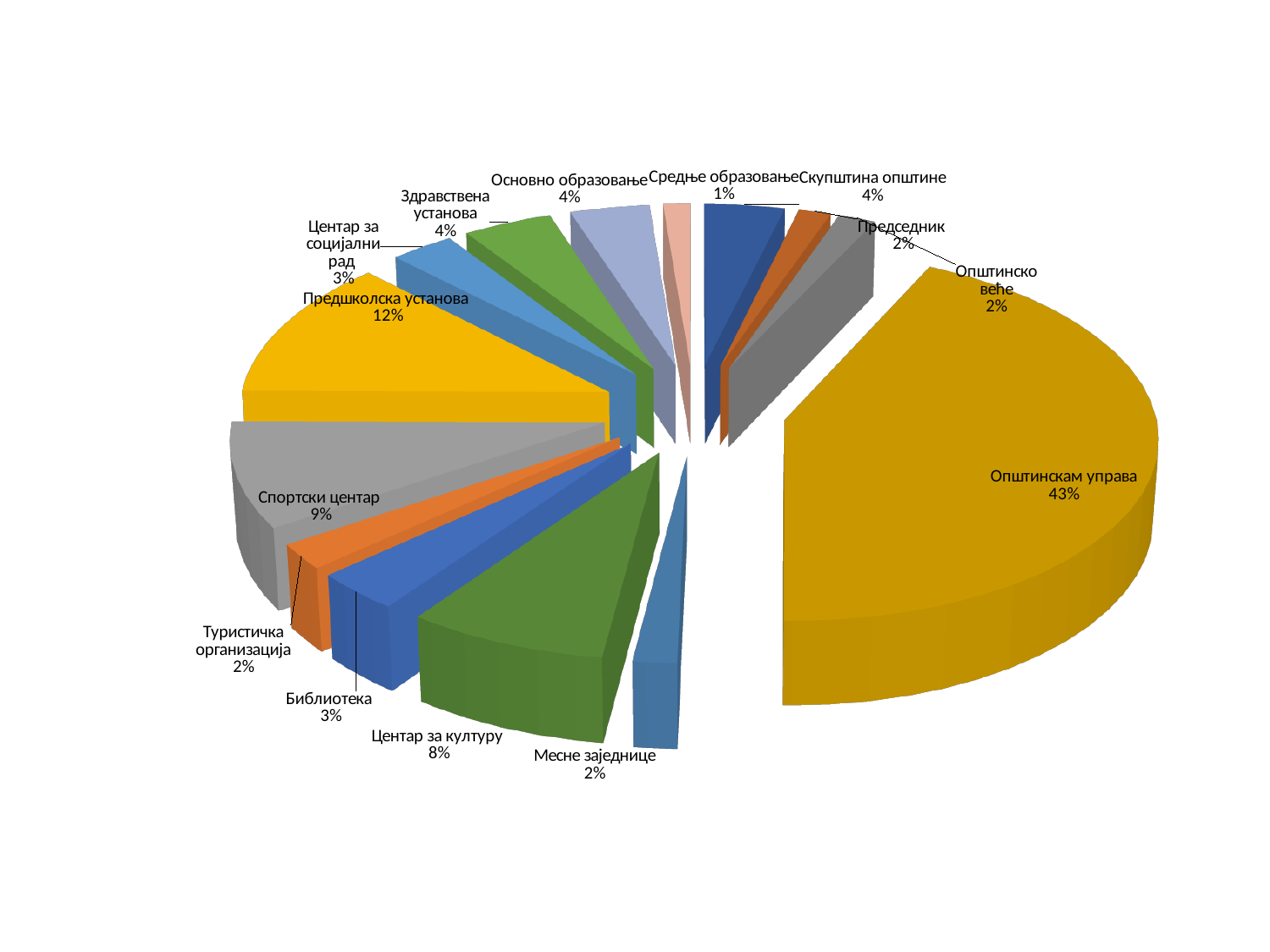
What share of the pie does Предшколска установа have? 12% What is the difference between the shares of Спортски центар and Центар за културу? 1% What share of the pie does Општинскам управа have? 43% What is the value shown for Центар за културу? 8% How many slices does the pie chart have? 14 Which category has the largest slice of the pie? Општинскам управа What is the value shown for Спортски центар? 9% Which is larger, the share for Предшколска установа or the share for Спортски центар? Предшколска установа What is the difference between the shares of Општинскам управа and Предшколска установа? 31% Which category has the smallest slice of the pie? Средње образовање What kind of chart is shown on the slide? Pie chart What is the value shown for Библиотека? 3%